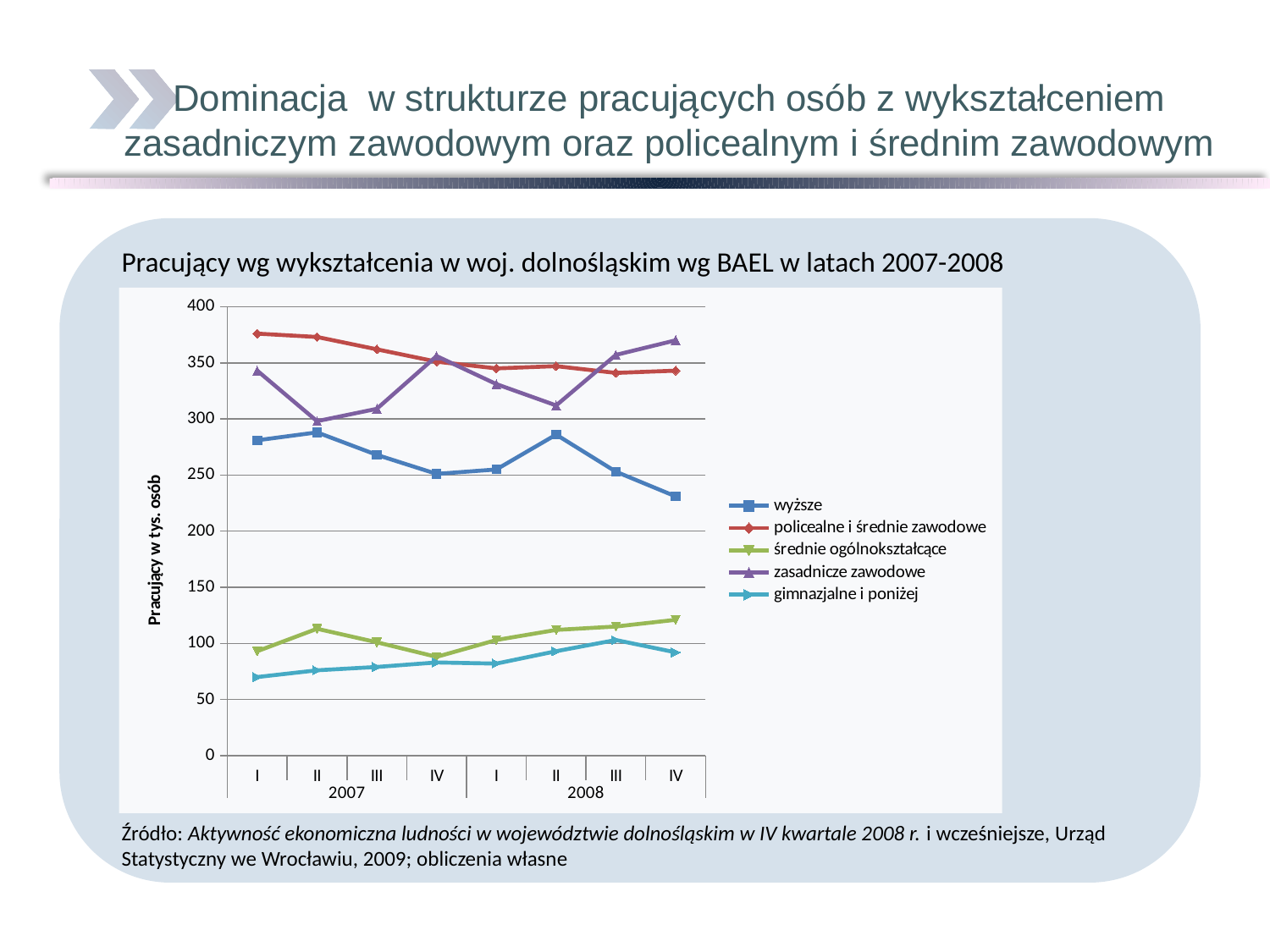
How many quarterly points are plotted along the x axis for each series? 8 In quarter IV of 2008, which is larger: 'zasadnicze zawodowe' or 'policealne i średnie zawodowe'? zasadnicze zawodowe Which series has the lowest values across all quarters shown? gimnazjalne i poniżej How many series does the legend list? 5 Does the 'średnie ogólnokształcące' series rise or fall overall from quarter I of 2007 to quarter IV of 2008? rise What is the label of the y axis? Pracujący w tys. osób What kind of chart is shown on the slide? line chart Is the value for 'zasadnicze zawodowe' in quarter IV of 2008 greater or less than 350? greater Which series has the highest value in quarter I of 2007? policealne i średnie zawodowe Is the value for 'gimnazjalne i poniżej' in quarter I of 2007 greater or less than 100? less Does the 'policealne i średnie zawodowe' series rise or fall overall from quarter I of 2007 to quarter IV of 2008? fall Is the value for 'wyższe' in quarter IV of 2008 greater or less than 250? less